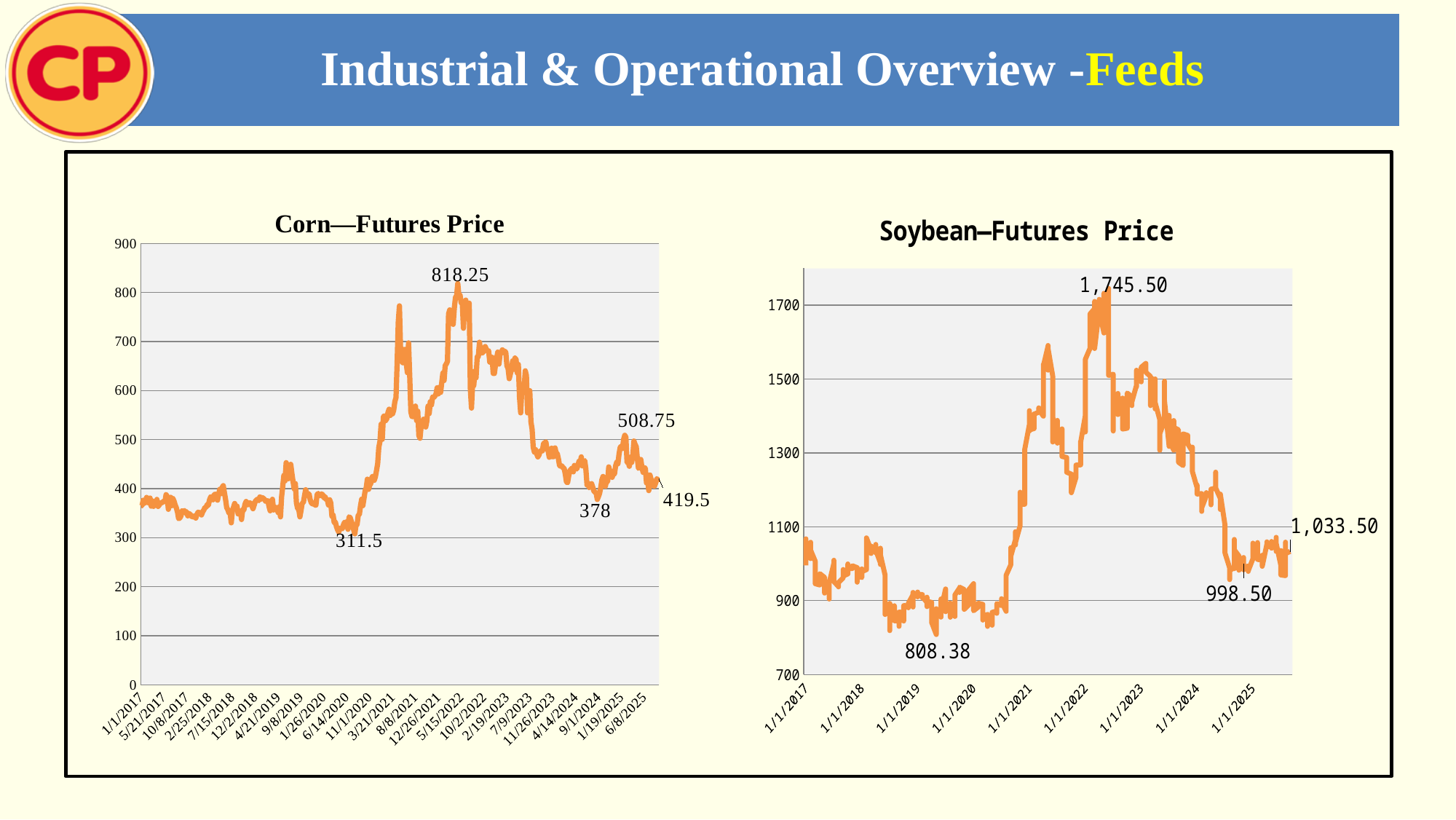
In the Corn—Futures Price chart, what is the highest labelled value? 818.25 How many charts are shown on the slide? 2 In the Corn—Futures Price chart, what is the difference between the peak value 818.25 and the low value 311.5? 506.75 What kind of chart is the Corn—Futures Price chart? line chart In the Corn—Futures Price chart, what is the last labelled value at the end of the series? 419.5 In the Soybean—Futures Price chart, what is the last labelled value at the end of the series? 1,033.50 In the Corn—Futures Price chart, what is the lowest labelled value? 311.5 In the Soybean—Futures Price chart, what is the highest labelled value? 1,745.50 In the Soybean—Futures Price chart, what is the lowest labelled value? 808.38 In the Soybean—Futures Price chart, is the value at 1/1/2017 greater or less than 900? greater In the Corn—Futures Price chart, which is larger: the labelled value 508.75 or the labelled value 378? 508.75 In the Soybean—Futures Price chart, what is the difference between the labelled values 1,033.50 and 998.50? 35.00